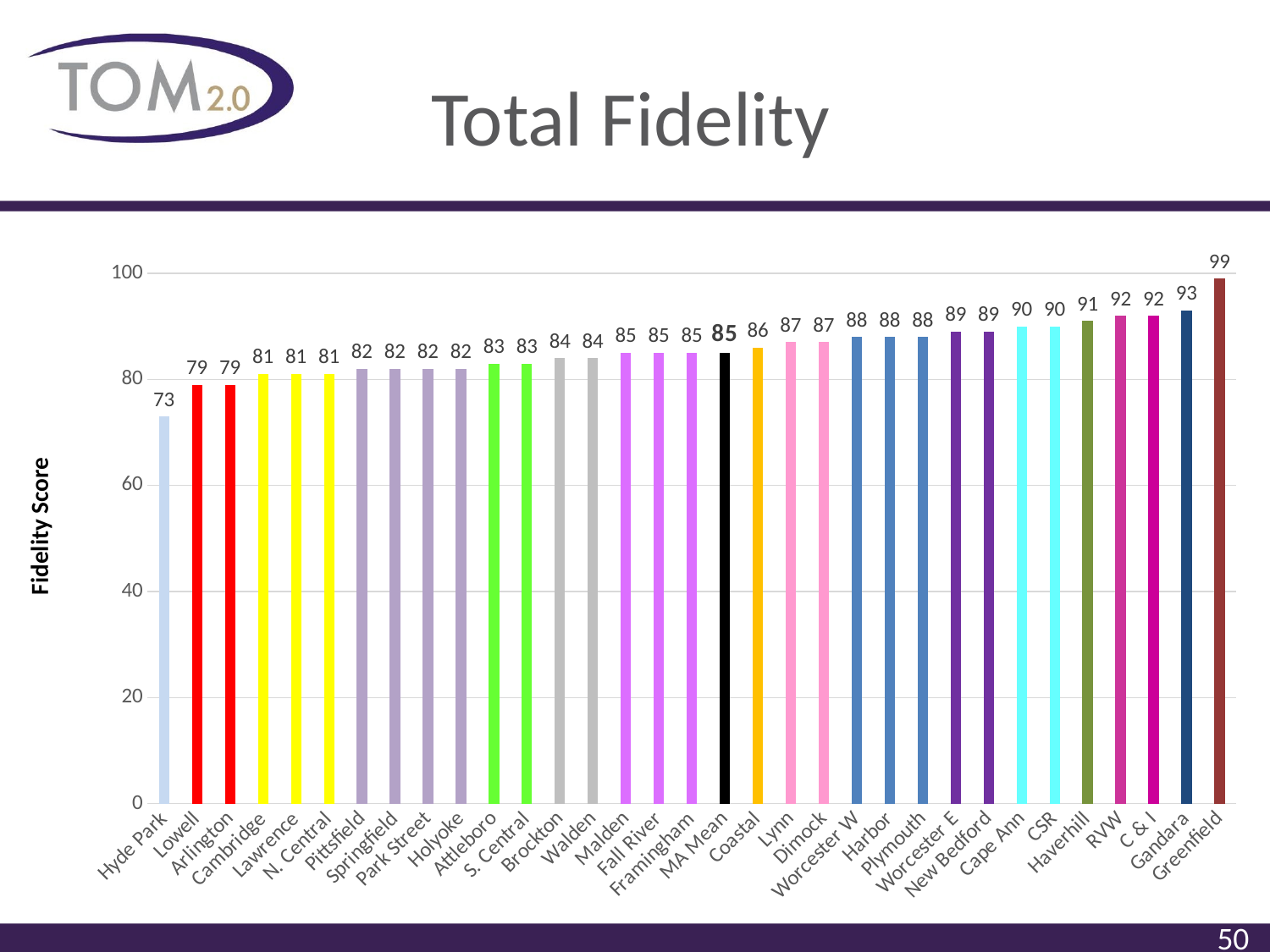
What is the fidelity score for Greenfield? 99 Which site has the lowest fidelity score? Hyde Park What type of chart is shown on the slide? Bar chart What is the label on the vertical axis of the chart? Fidelity Score How many bars are plotted on the chart? 33 What is the MA Mean fidelity score shown on the chart? 85 Which site has the highest fidelity score? Greenfield Is the fidelity score for Hyde Park greater or less than 80? less What is the fidelity score for Gandara? 93 Which has a higher fidelity score, Lowell or Haverhill? Haverhill What is the difference between Greenfield's and Hyde Park's fidelity scores? 26 What is the fidelity score for Hyde Park? 73